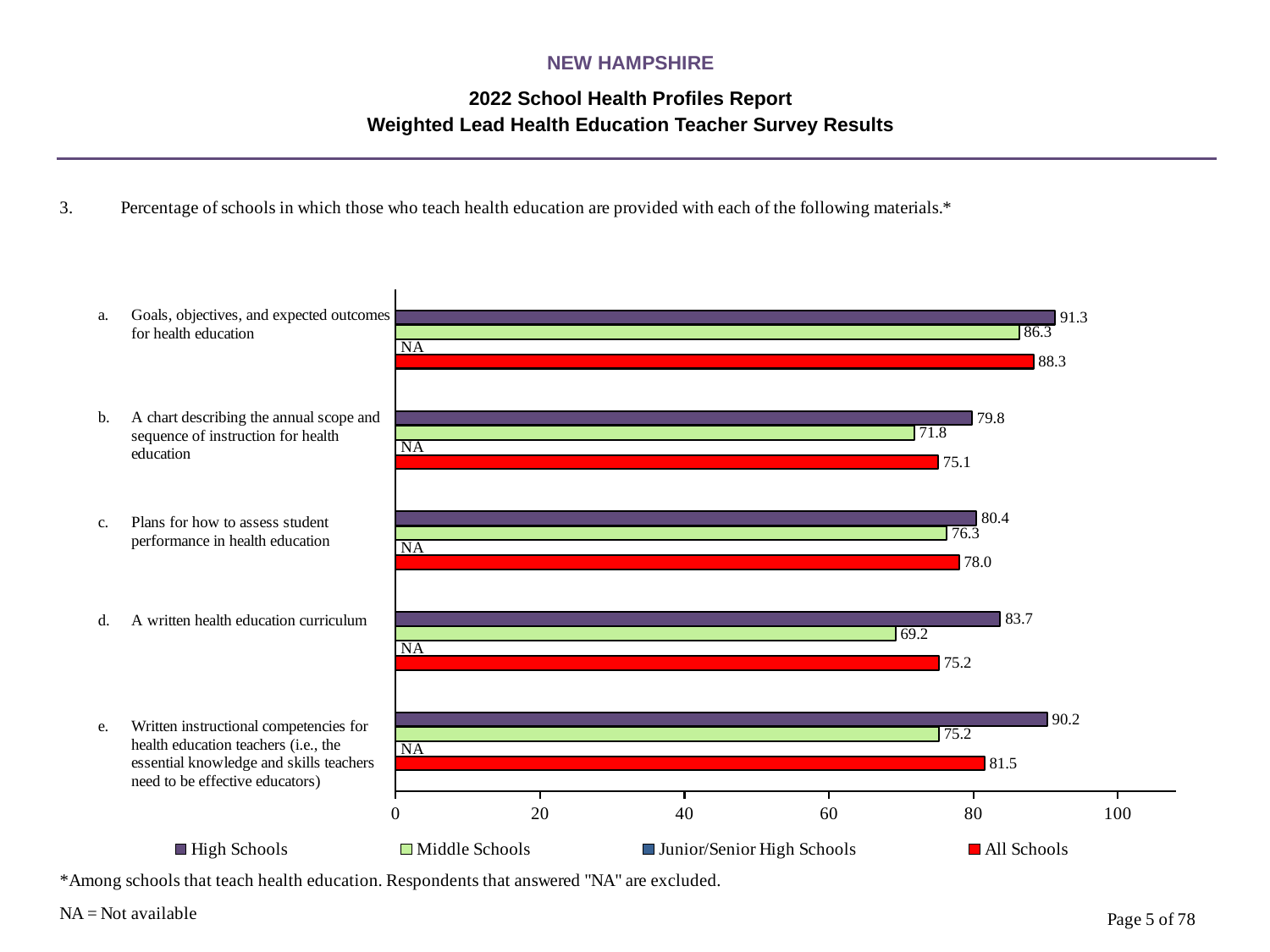
What is the All Schools value for 'A chart describing the annual scope and sequence of instruction for health education'? 75.1 What kind of chart is shown on the slide? Bar chart Which is larger for 'Plans for how to assess student performance in health education': the High Schools value or the All Schools value? High Schools What value is shown for Junior/Senior High Schools in each category? NA What is the Middle Schools value for 'A written health education curriculum'? 69.2 Which category has the highest High Schools value? Goals, objectives, and expected outcomes for health education How many series does the legend list? 4 Which category has the lowest Middle Schools value? A written health education curriculum What is the High Schools value for 'Goals, objectives, and expected outcomes for health education'? 91.3 How many categories (materials) are shown on the chart? 5 What colour represents the All Schools series in the legend? Red What is the difference between the High Schools and Middle Schools values for 'Written instructional competencies for health education teachers'? 15.0